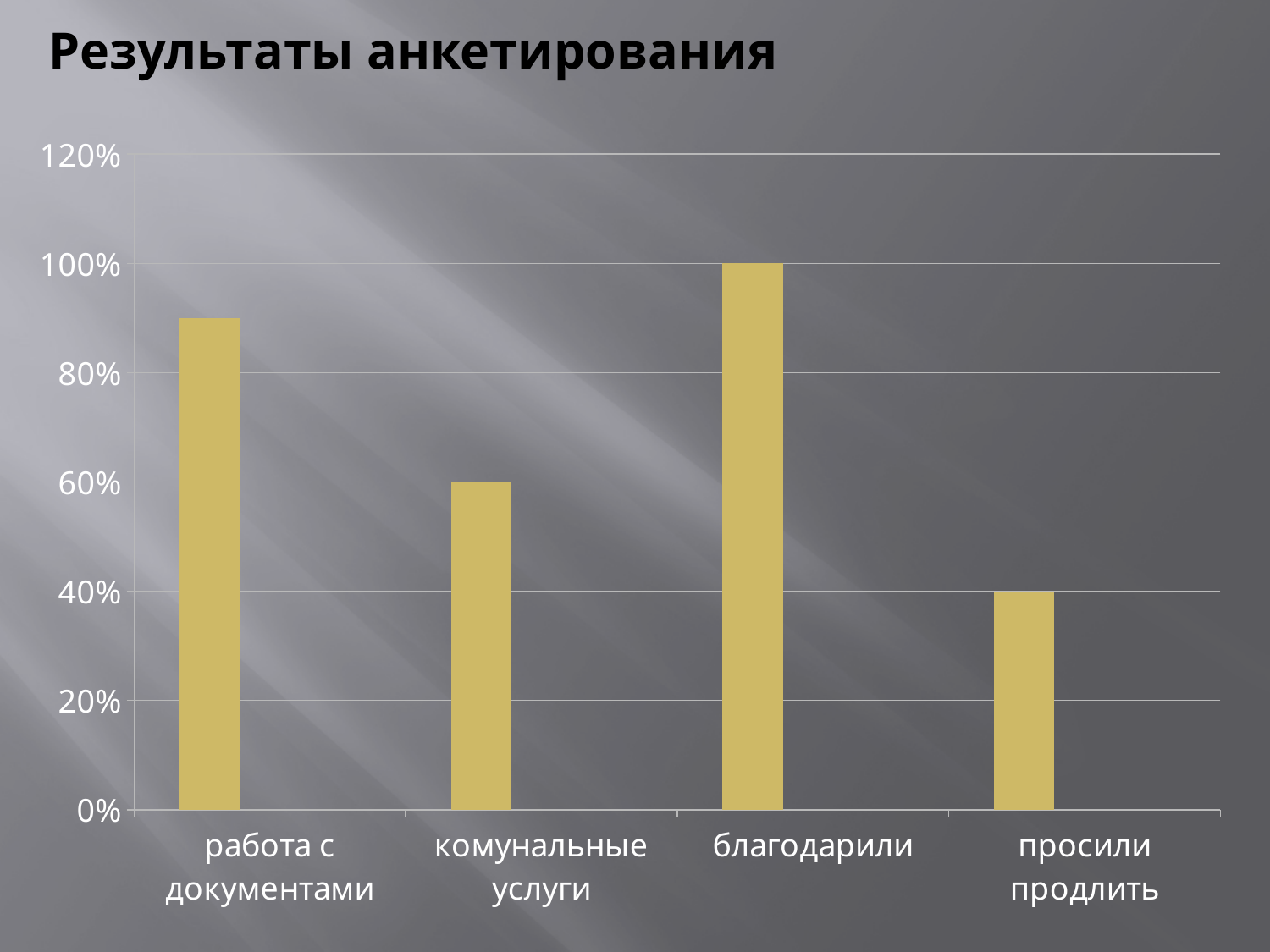
What is the value for благодарили? 100% Which category has the lowest value? просили продлить What is the difference between the values for комунальные услуги and просили продлить? 20% What is the difference between the values for благодарили and комунальные услуги? 40% Which category has the highest value? благодарили How many categories are shown on the x axis? 4 What is the value for комунальные услуги? 60% What type of chart is shown on the slide? bar chart What is the title of the chart? Результаты анкетирования Which is larger, the value for работа с документами or the value for комунальные услуги? работа с документами What is the value for просили продлить? 40% Is the value for работа с документами greater or less than 80%? greater